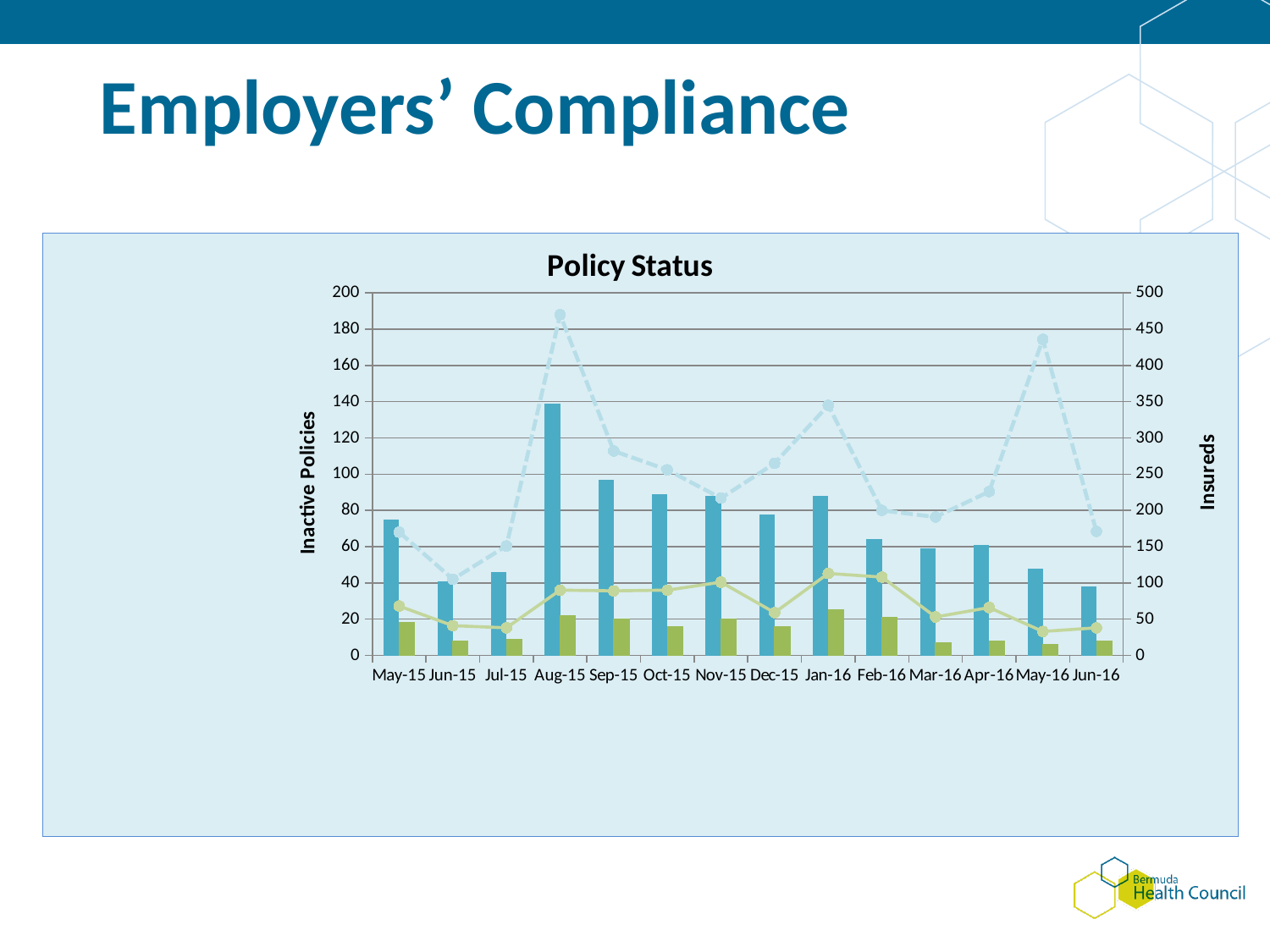
Which month has the taller blue bar, May-15 or Jun-15? May-15 What kind of chart is shown on the slide? Combined bar and line chart In which month is the green bar the tallest? Jan-16 What is the title of the left vertical axis? Inactive Policies In which month is the blue bar the tallest? Aug-15 What is the title of the chart? Policy Status In which month does the dashed line reach its lowest point? Jun-15 Is the blue bar for Aug-15 greater or less than 120 on the Inactive Policies axis? greater Is the blue bar for Jun-15 greater or less than 60 on the Inactive Policies axis? less In which month does the dashed line reach its highest point? Aug-15 Is the dashed line value for Jan-16 greater or less than 300 on the Insureds axis? greater How many months are shown along the x axis of the chart? 14